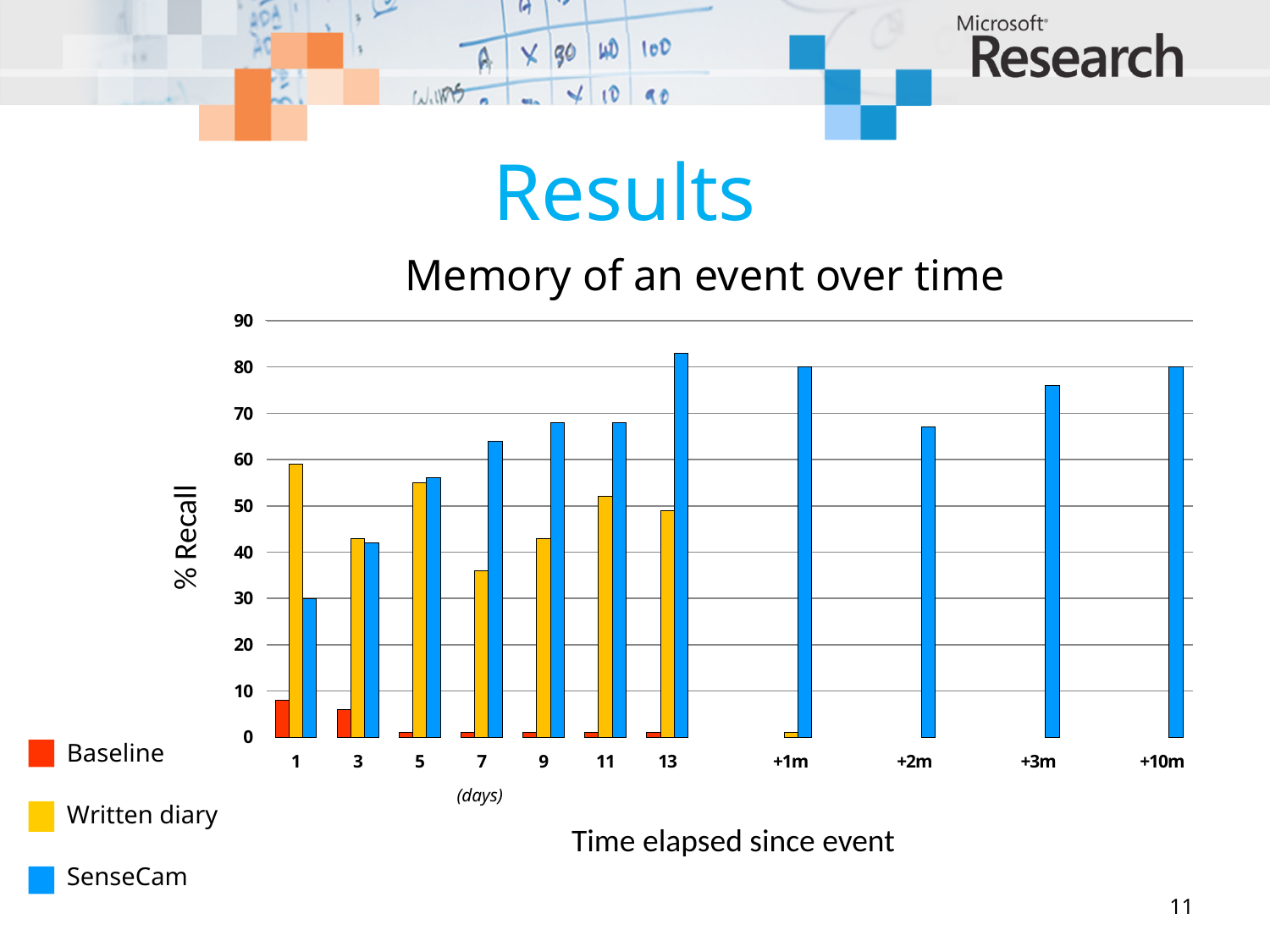
At day 1, which is larger: Written diary or SenseCam? Written diary At which time point is the SenseCam value lowest? 1 At which time point is the Written diary value highest? 1 What is the label on the y axis? % Recall How many series does the legend list? 3 What kind of chart is shown on the slide? bar chart At day 13, which is larger: Written diary or SenseCam? SenseCam Is the SenseCam value at day 13 greater or less than 80? greater How many time categories are shown on the x axis? 11 What is the title of the chart? Memory of an event over time Is the Written diary value at day 7 greater or less than 40? less Does the SenseCam value rise or fall from day 1 to day 13? rise